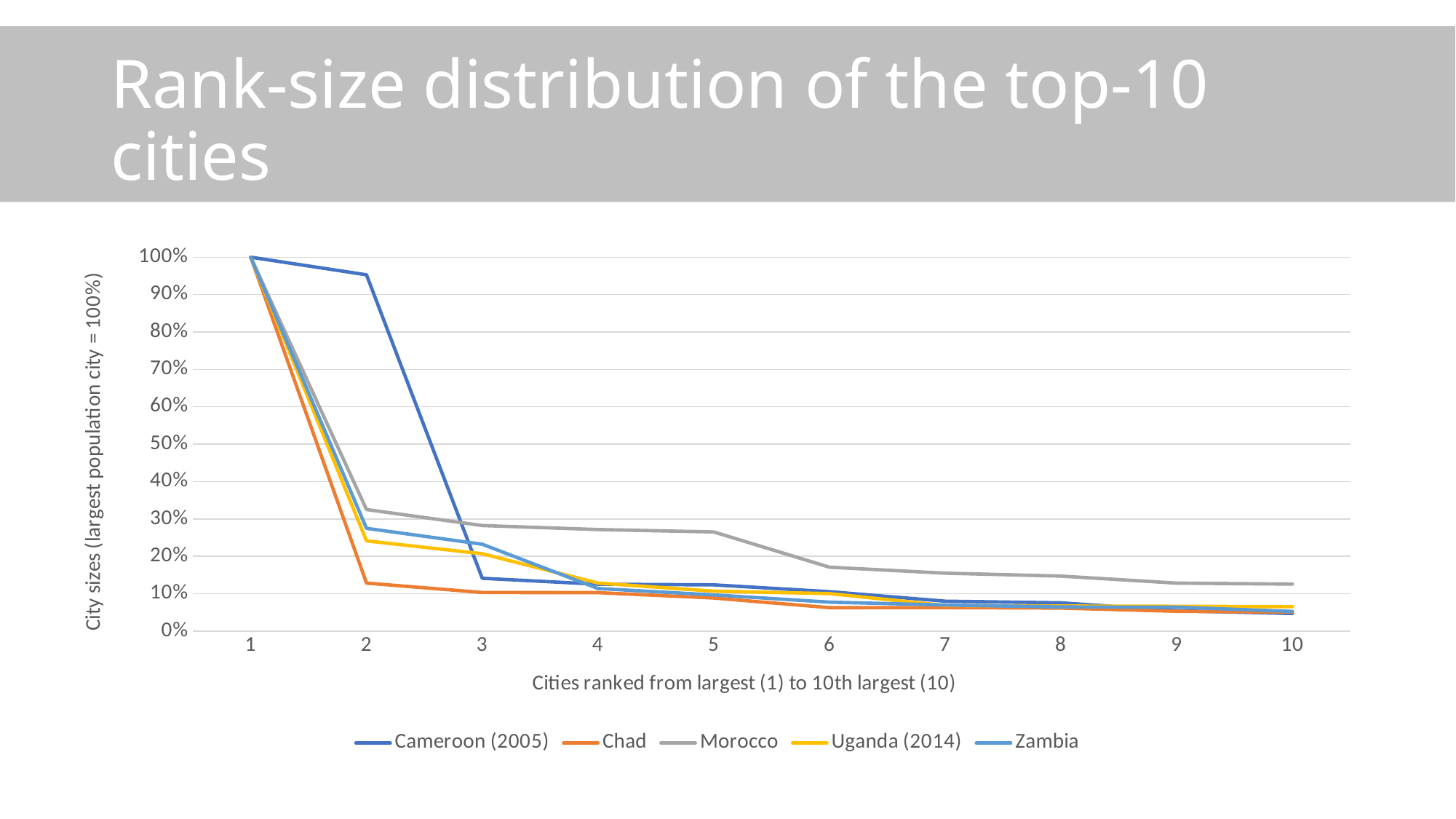
How many series does the legend list? 5 Which series has the lowest value at rank 2? Chad At rank 5, which is larger: the value for Morocco or the value for Chad? Morocco Which series has the highest value at rank 10? Morocco Do the values for Chad rise or fall as the city rank increases from 1 to 10? fall Is the value for Morocco at rank 10 greater or less than 10%? greater How many city ranks are plotted along the x axis? 10 What kind of chart is shown on the slide? line chart Is the value for Cameroon (2005) at rank 2 greater or less than 90%? greater Which series has the highest value at rank 2? Cameroon (2005) Is the value for Chad at rank 2 greater or less than 20%? less What is the value for Morocco at rank 1? 100%